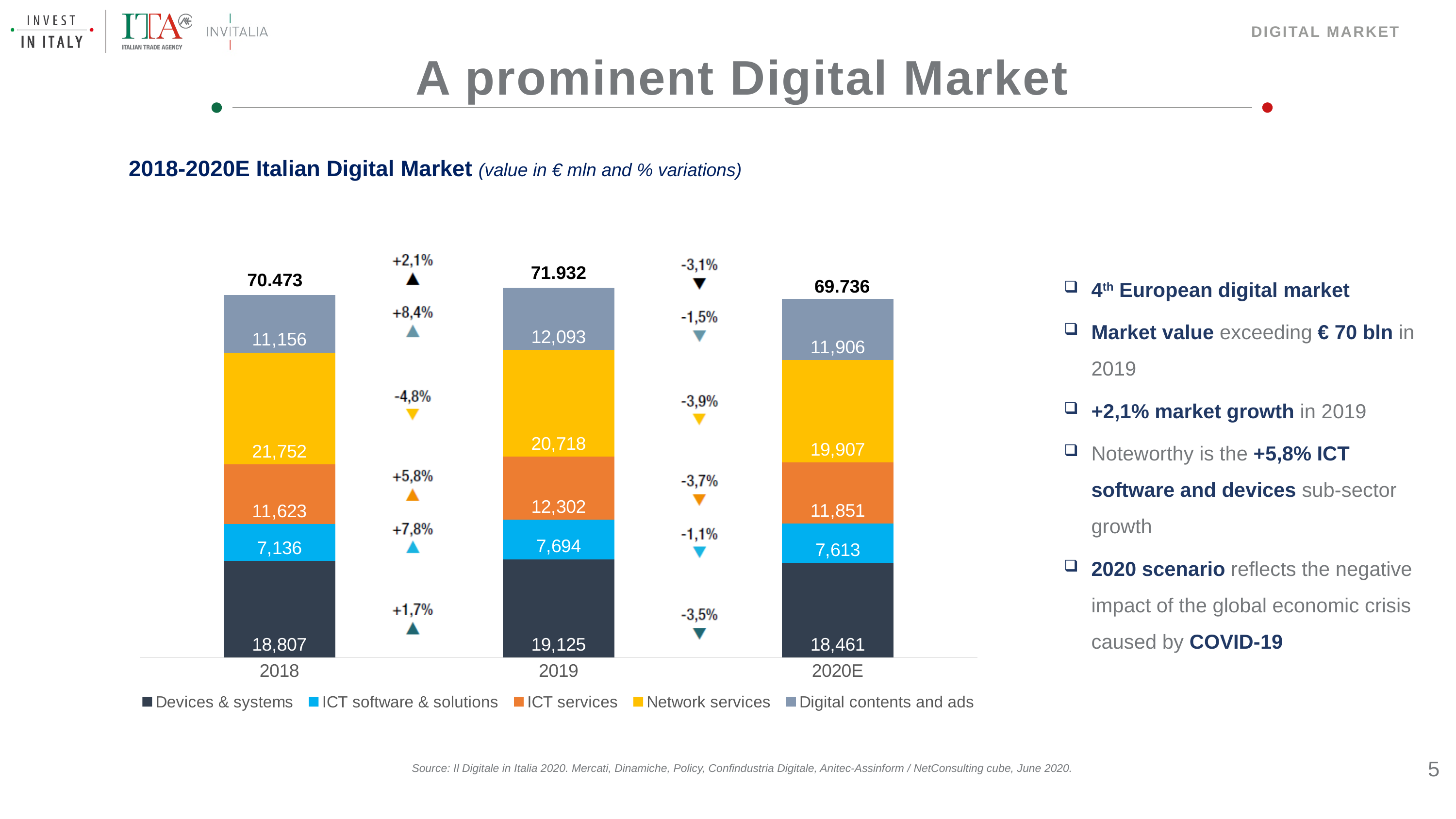
What is the value for Digital contents and ads in 2020E? 11,906 Which is larger, the ICT services value in 2019 or in 2020E? 2019 What is the value for Devices & systems in 2019? 19,125 What is the value for ICT software & solutions in 2018? 7,136 Which year has the highest total market value? 2019 Which year has the lowest total market value? 2020E What is the value for Network services in 2018? 21,752 What is the difference between the Network services value in 2018 and in 2019? 1,034 What kind of chart is shown on the slide? Stacked bar chart What is the total value of the stacked bar for 2019? 71.932 How many years (bars) are shown on the chart? 3 How many series does the legend list? 5